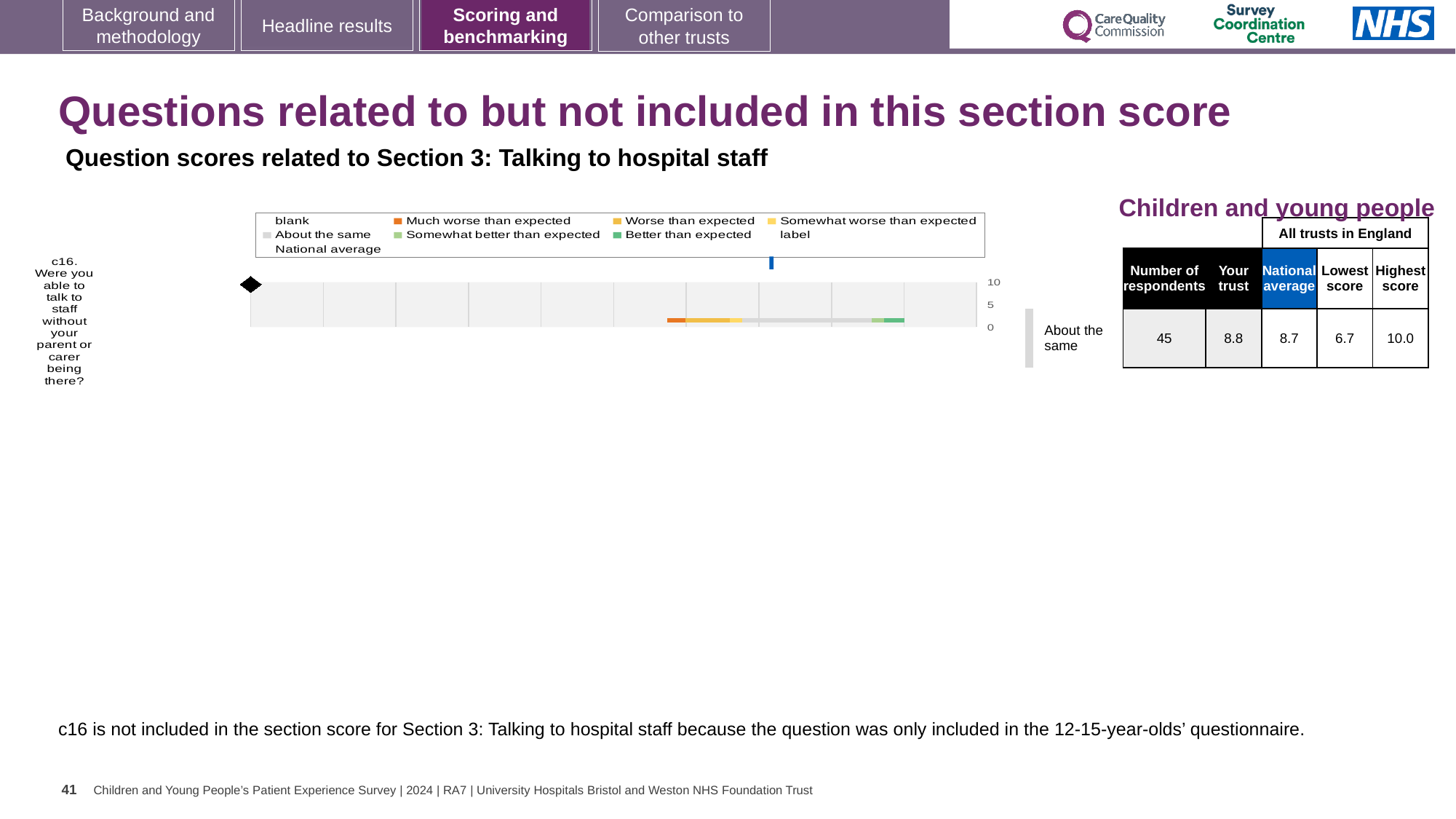
What kind of chart is shown on the slide? bar chart How many entries does the chart legend list? 9 Which question number is plotted in the chart? c16 What is the highest tick value shown on the chart's axis? 10 How many questions (categories) are plotted in the chart? 1 Which legend entry is shown in orange? Much worse than expected What rating label is shown next to the chart for question c16? About the same